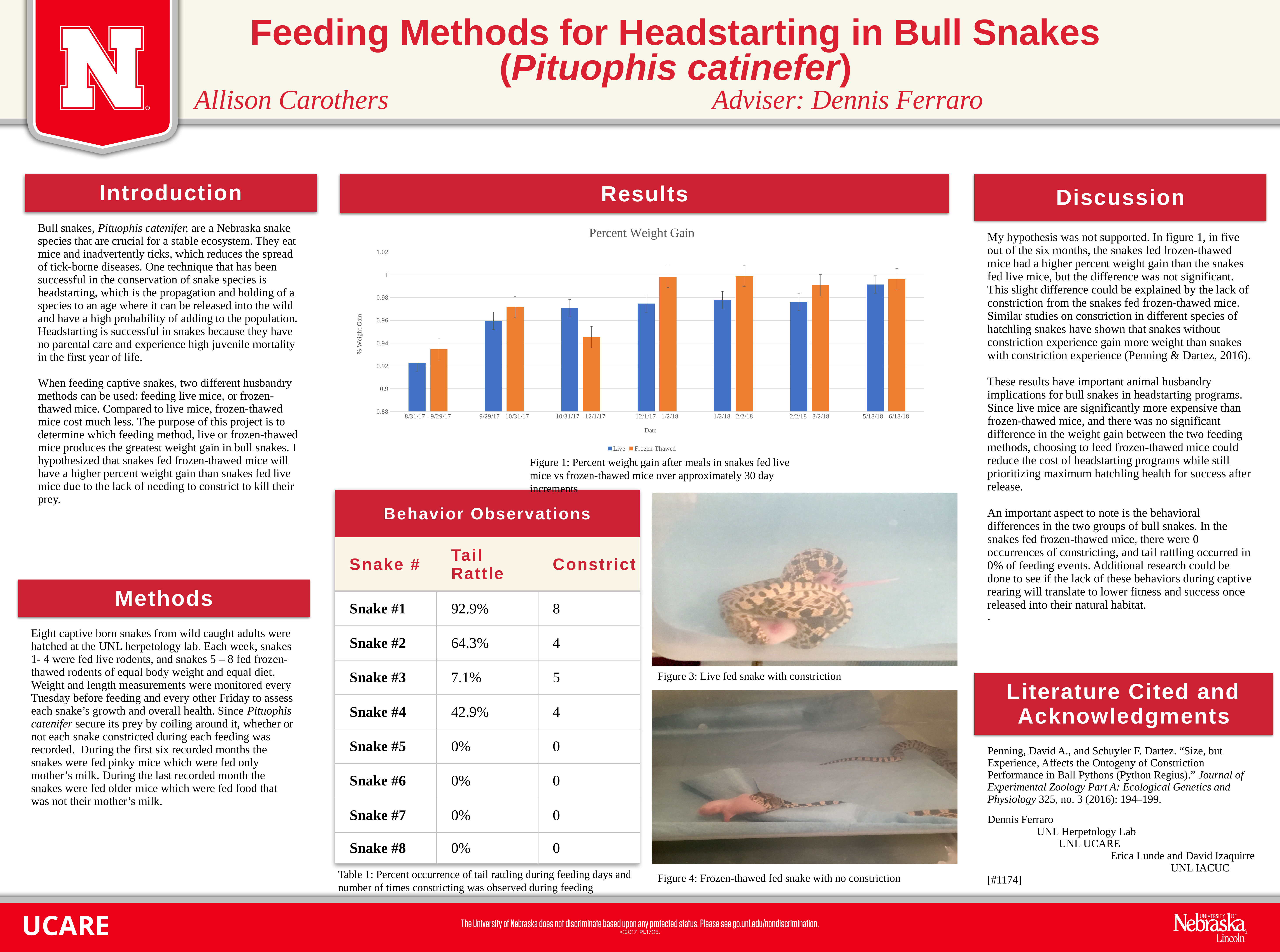
What kind of chart is the Percent Weight Gain chart? bar chart In the Percent Weight Gain chart, which date period has the highest value for the Live series? 5/18/18 - 6/18/18 How many date categories are shown on the x axis of the Percent Weight Gain chart? 7 How many series does the legend of the Percent Weight Gain chart list? 2 What are the two legend entries in the Percent Weight Gain chart? Live and Frozen-Thawed In the Percent Weight Gain chart, for 10/31/17 - 12/1/17, which series has the larger value, Live or Frozen-Thawed? Live In the Percent Weight Gain chart, which date period has the lowest value for the Live series? 8/31/17 - 9/29/17 In the Percent Weight Gain chart, is the Live value for 8/31/17 - 9/29/17 greater or less than 0.94? less What is the title of the chart in the Results section? Percent Weight Gain In the Percent Weight Gain chart, is the Frozen-Thawed value for 12/1/17 - 1/2/18 greater or less than 0.98? greater In the Percent Weight Gain chart, for 8/31/17 - 9/29/17, which series has the larger value, Live or Frozen-Thawed? Frozen-Thawed In the Percent Weight Gain chart, which date period has the lowest value for the Frozen-Thawed series? 8/31/17 - 9/29/17